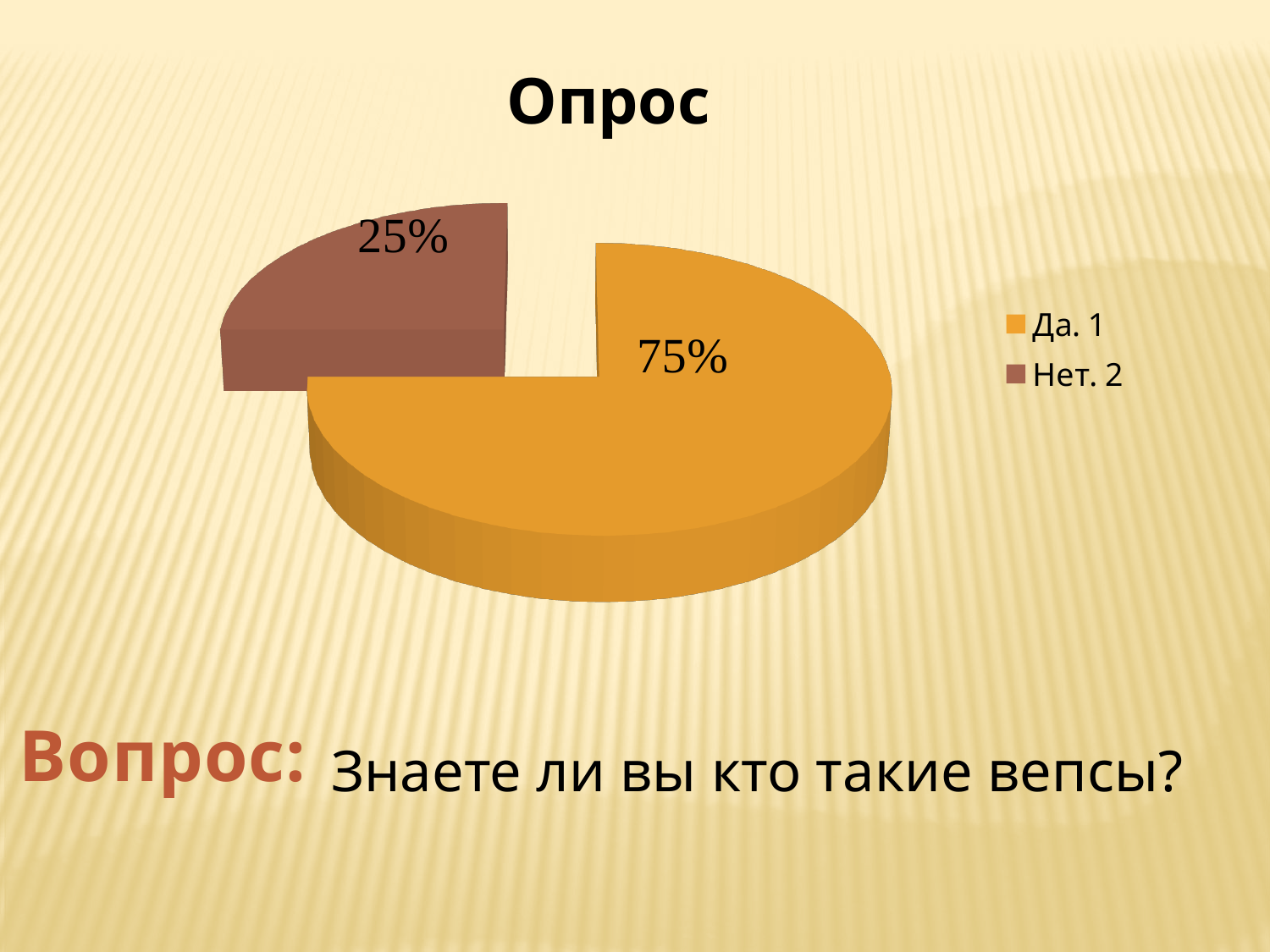
Which slice is larger, "Да. 1" or "Нет. 2"? Да. 1 What kind of chart is shown on the slide? Pie chart What is the title of the chart? Опрос Which category has the largest slice of the pie? Да. 1 How many slices does the pie chart have? 2 How many entries does the legend list? 2 What is the difference in percentage points between the "Да. 1" and "Нет. 2" slices? 50% What share of the pie does the "Нет. 2" slice represent? 25% What colour is the "Нет. 2" slice? Brown Which category has the smallest slice of the pie? Нет. 2 What share of the pie does the "Да. 1" slice represent? 75%